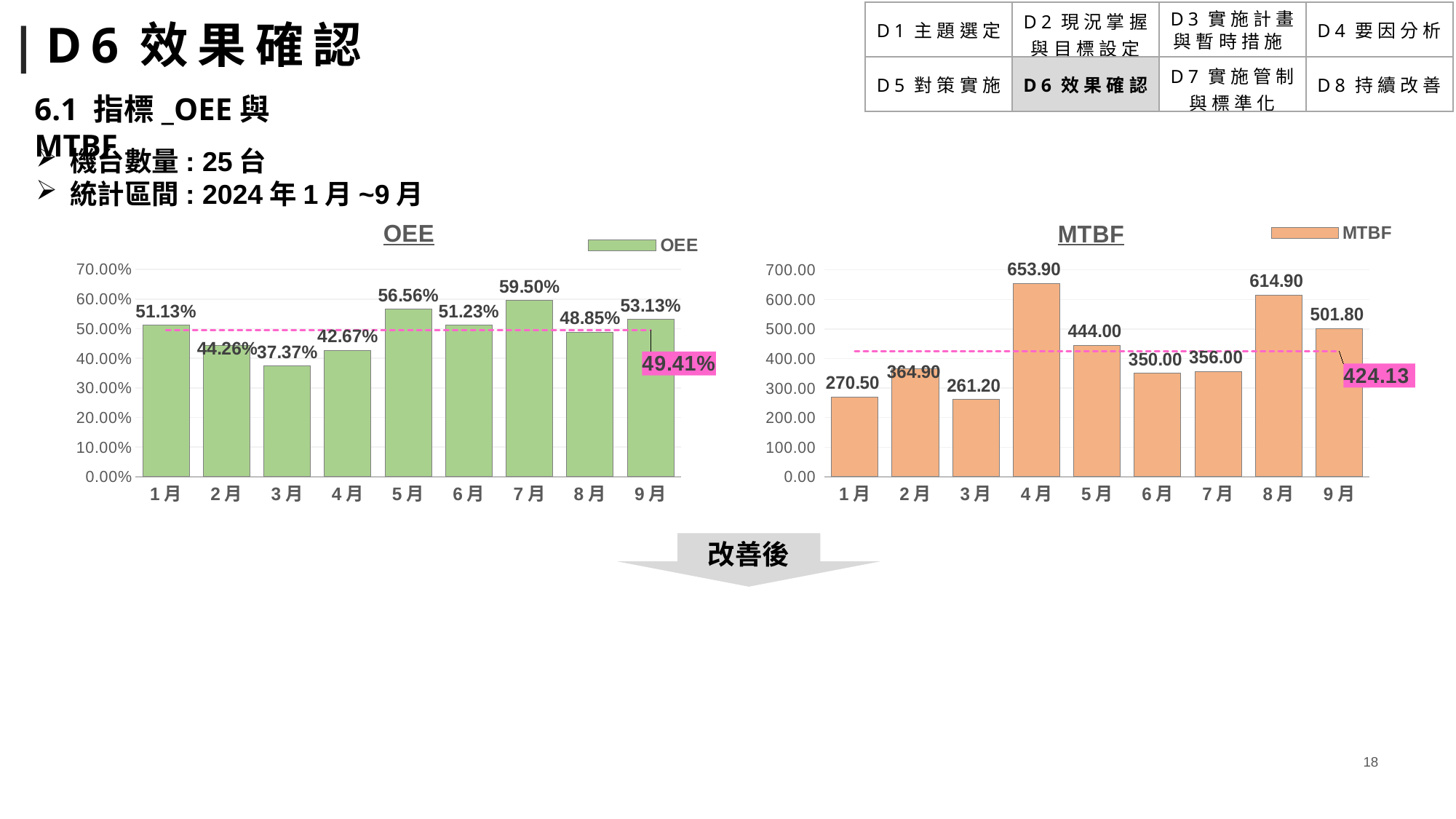
In the OEE chart, which month has the lowest value? 3月 What kind of chart is the MTBF chart? bar chart In the OEE chart, which month has the highest value? 7月 In the MTBF chart, is the value for 2月 greater or less than 400.00? less In the OEE chart, what is the value for 7月? 59.50% In the MTBF chart, what is the value for 4月? 653.90 In the MTBF chart, which month has the lowest value? 3月 What value is shown in the highlighted label next to the dashed line in the MTBF chart? 424.13 In the OEE chart, what is the difference between the values for 7月 and 3月? 22.13% In the MTBF chart, which is larger, the value for 5月 or the value for 9月? 9月 In the OEE chart, how many months are plotted? 9 In the MTBF chart, what is the difference between the values for 8月 and 1月? 344.40